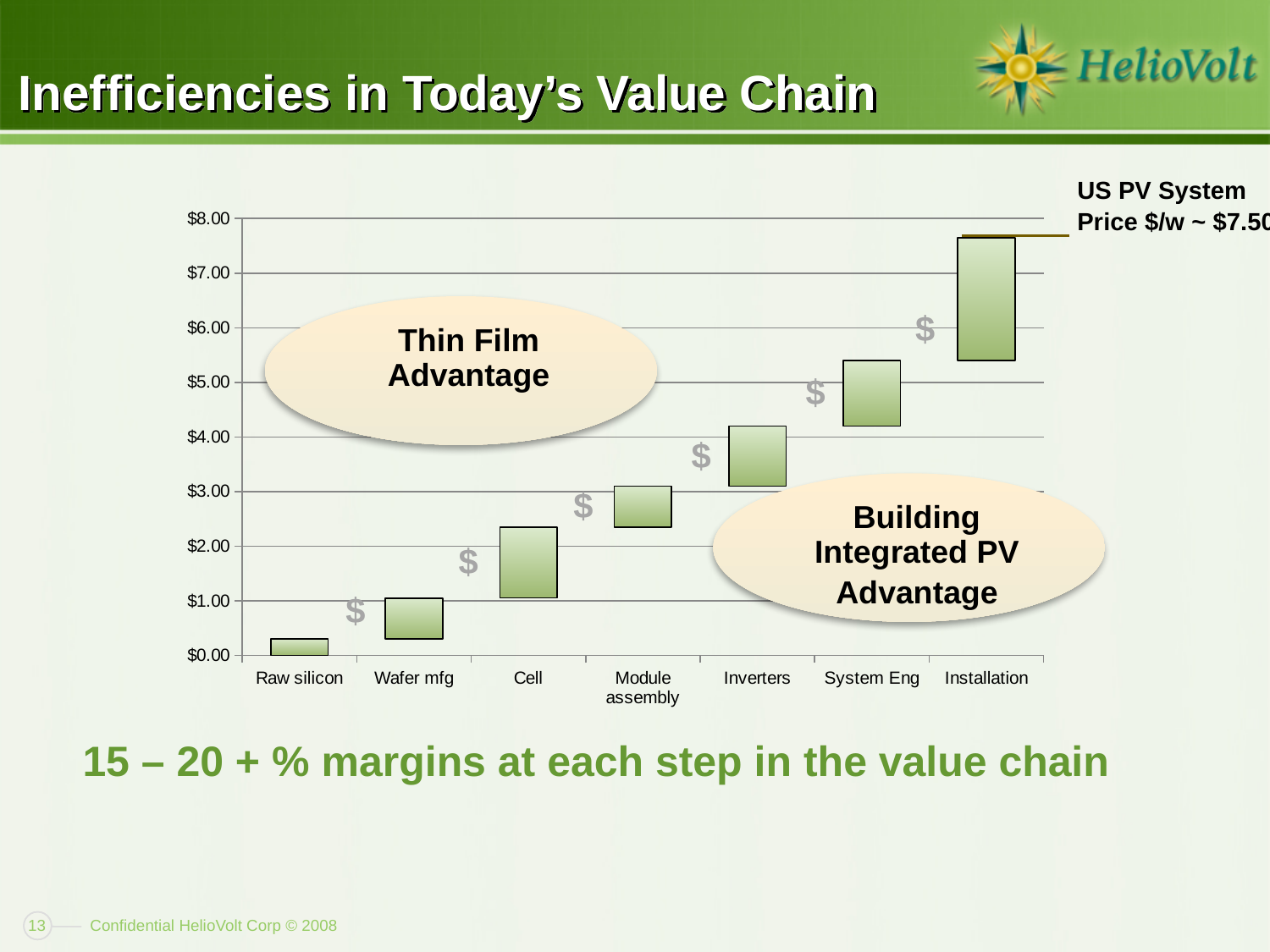
Is the top of the System Eng bar greater or less than $5.00? greater Which value-chain step reaches the highest cumulative price on the chart? Installation Which reaches a higher cumulative price on the chart, Cell or Inverters? Inverters Do the cumulative values rise or fall moving from Raw silicon to Installation along the x axis? rise Which value-chain step has the lowest cumulative price on the chart? Raw silicon What US PV system price per watt is noted at the top right of the chart? ~ $7.50 How many value-chain steps are shown along the x axis of the chart? 7 Is the top of the Installation bar greater or less than $7.00? greater Is the top of the Raw silicon bar greater or less than $1.00? less What is the title of the slide containing the chart? Inefficiencies in Today's Value Chain What kind of chart is shown on the slide? bar chart